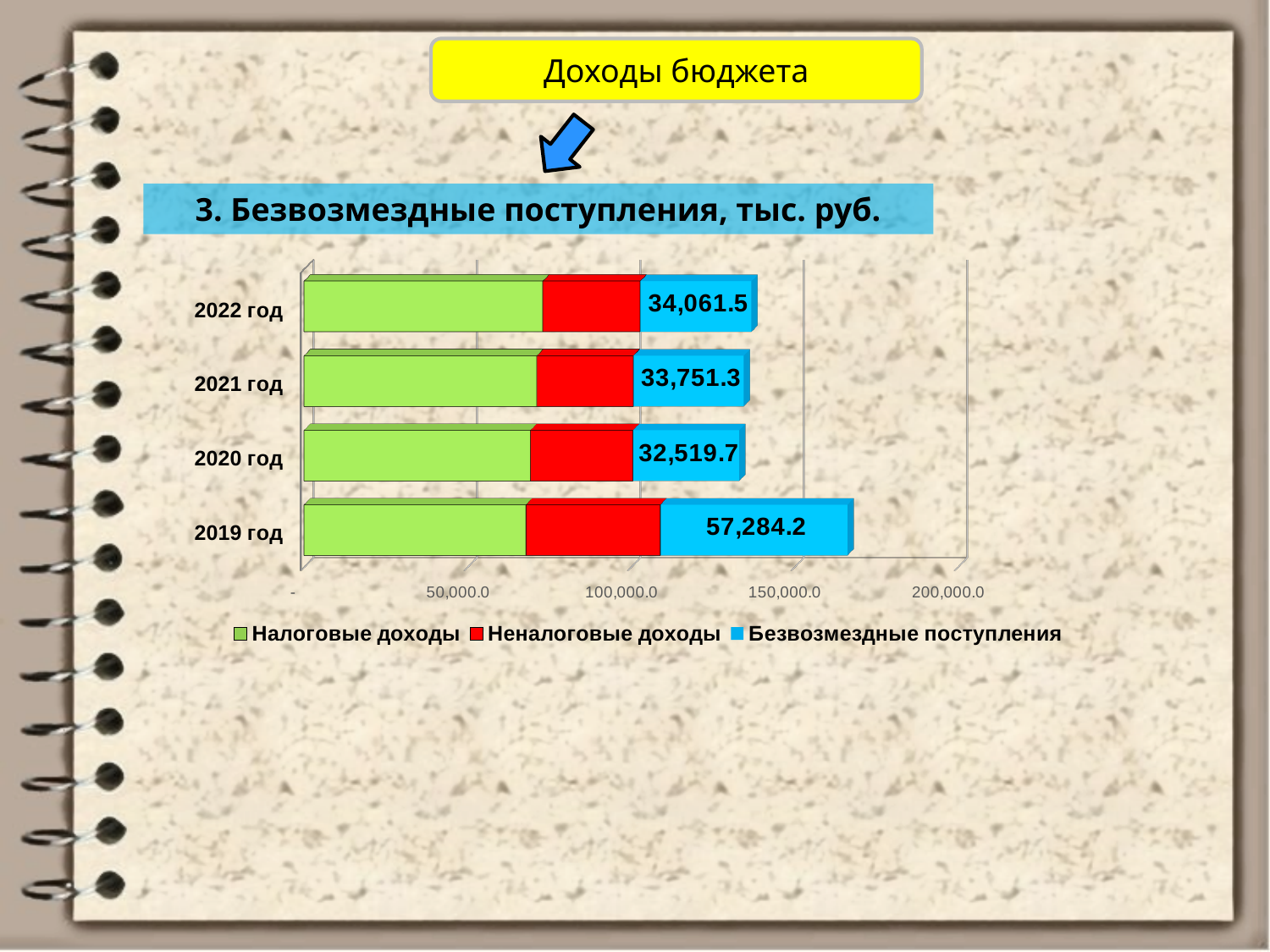
What is the value of Безвозмездные поступления for 2019 год? 57,284.2 Which year has the lowest value of Безвозмездные поступления? 2020 год How many series does the legend list? 3 Which year has the highest value of Безвозмездные поступления? 2019 год How many years are shown on the chart? 4 What kind of chart is shown on the slide? Stacked bar chart What is the value of Безвозмездные поступления for 2022 год? 34,061.5 Is the total length of the stacked bar for 2019 год greater or less than 150,000.0? greater What is the difference between the Безвозмездные поступления values for 2019 год and 2020 год? 24,764.5 What is the value of Безвозмездные поступления for 2021 год? 33,751.3 Which year has the larger value of Безвозмездные поступления, 2022 год or 2021 год? 2022 год What is the value of Безвозмездные поступления for 2020 год? 32,519.7